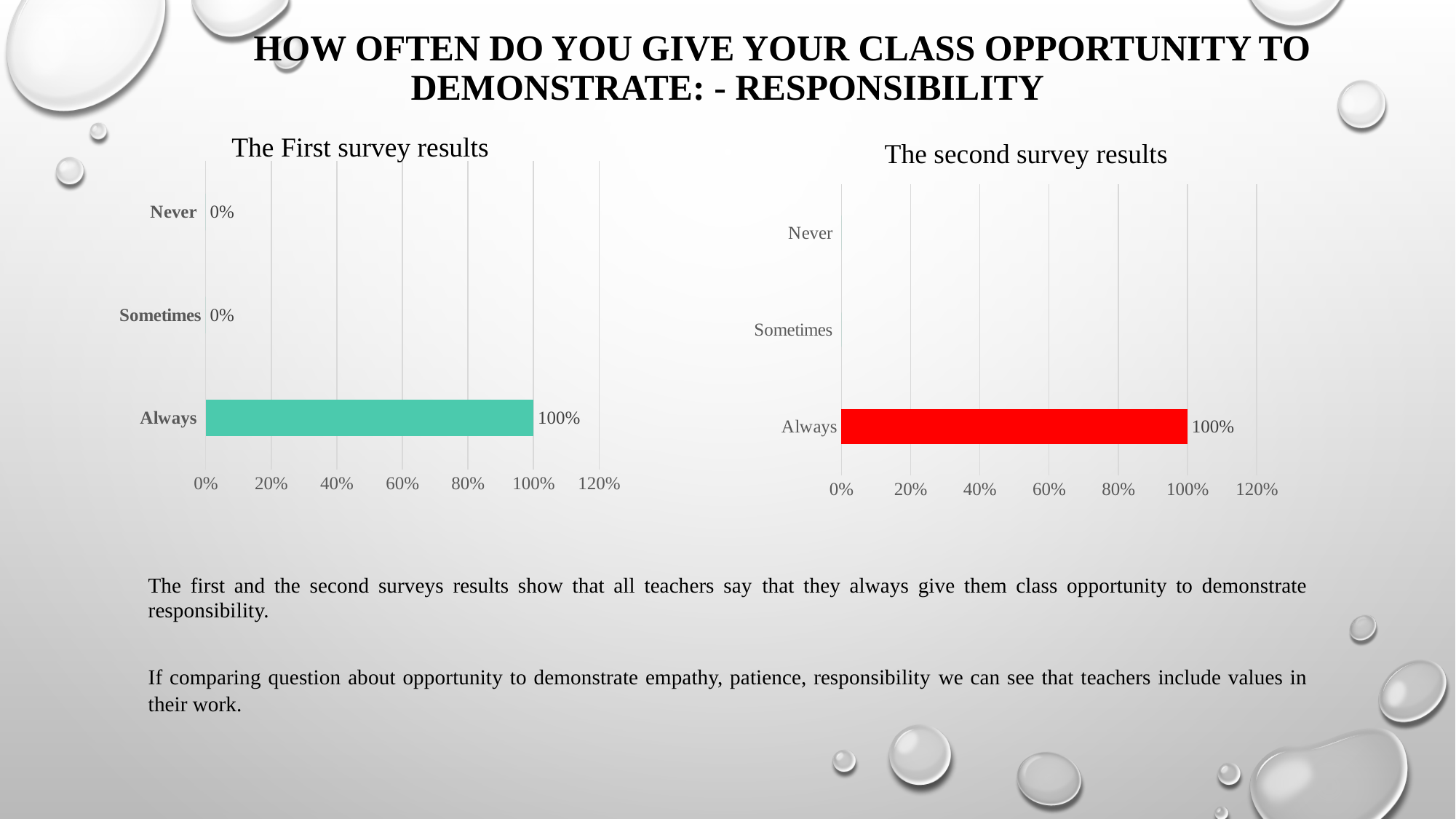
What kind of chart is "The First survey results"? bar chart In the chart titled "The First survey results", what is the value for Never? 0% In the chart titled "The second survey results", is the value for Always greater or less than 80%? greater How many categories are shown in the chart titled "The second survey results"? 3 In the chart titled "The First survey results", what is the value for Sometimes? 0% In the chart titled "The First survey results", what is the difference between the values for Always and Sometimes? 100% In the chart titled "The second survey results", which category has the highest value? Always In the chart titled "The First survey results", which category has the highest value? Always What colour is the bar in the chart titled "The second survey results"? red In the chart titled "The second survey results", what is the value for Always? 100% In the chart titled "The First survey results", which is larger, the value for Always or the value for Never? Always In the chart titled "The First survey results", what is the value for Always? 100%